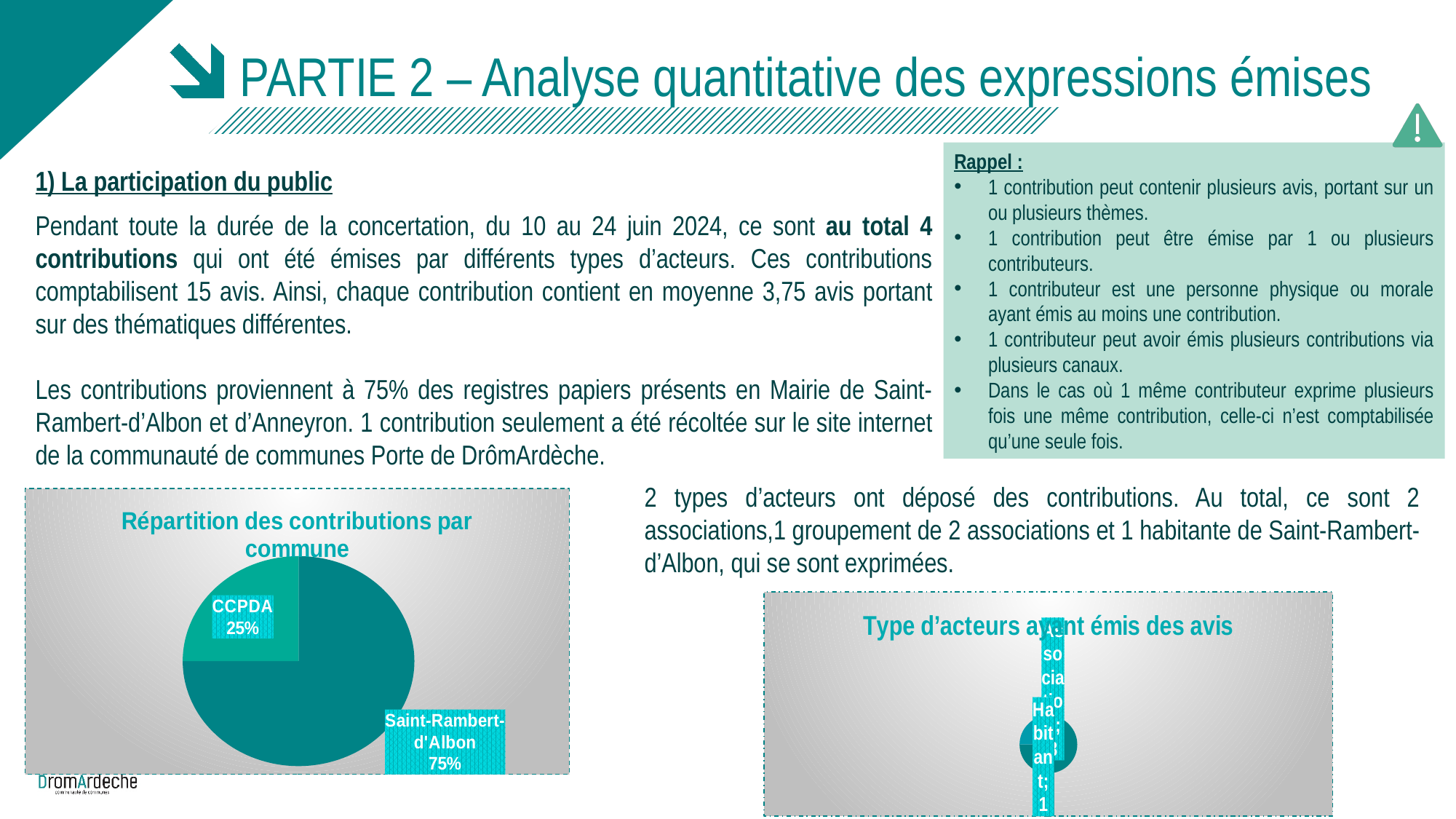
In the chart 'Répartition des contributions par commune', which is larger: the share for CCPDA or the share for Saint-Rambert-d'Albon? Saint-Rambert-d'Albon In the chart 'Répartition des contributions par commune', which commune has the smallest share? CCPDA In the chart 'Répartition des contributions par commune', what share of contributions comes from Saint-Rambert-d'Albon? 75% What is the title of the chart on the bottom right of the slide? Type d'acteurs ayant émis des avis In the chart 'Répartition des contributions par commune', which commune has the largest share? Saint-Rambert-d'Albon In the chart 'Répartition des contributions par commune', what is the difference in percentage points between Saint-Rambert-d'Albon and CCPDA? 50 percentage points In the chart 'Répartition des contributions par commune', what share of contributions comes from CCPDA? 25% How many slices does the pie chart 'Répartition des contributions par commune' have? 2 What is the title of the pie chart on the left of the slide? Répartition des contributions par commune What kind of chart is 'Répartition des contributions par commune'? pie chart